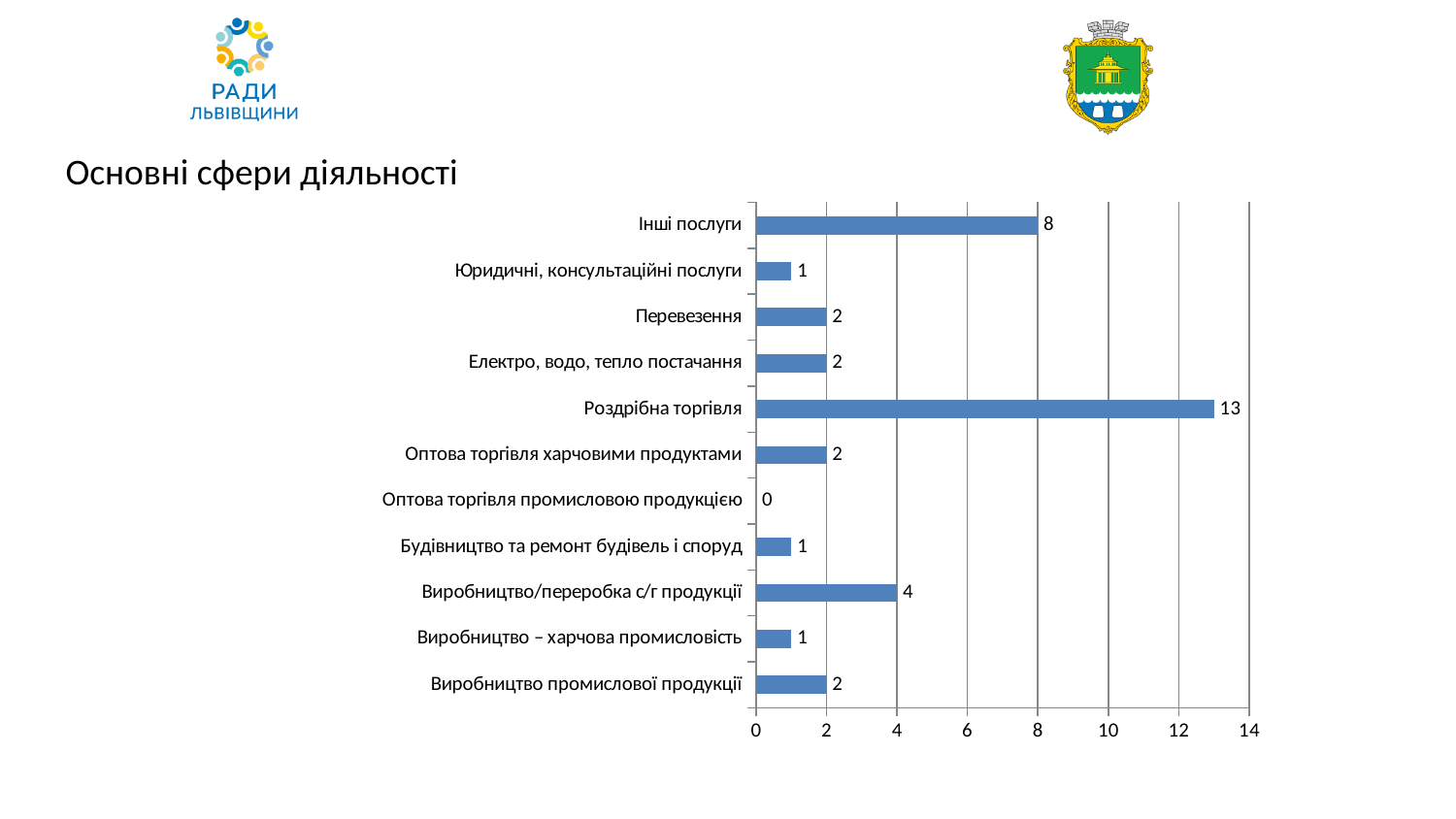
What is the value for Оптова торгівля промисловою продукцією? 0 Which category has the lowest value? Оптова торгівля промисловою продукцією What kind of chart is shown on the slide? bar chart What is the difference between the values for Роздрібна торгівля and Інші послуги? 5 What is the value for Інші послуги? 8 How many categories are shown in the chart? 11 What is the value for Роздрібна торгівля? 13 What is the title of the slide? Основні сфери діяльності Which category has the highest value? Роздрібна торгівля What is the value for Виробництво/переробка с/г продукції? 4 Which is larger, the value for Виробництво/переробка с/г продукції or the value for Перевезення? Виробництво/переробка с/г продукції Is the value for Роздрібна торгівля greater or less than 10? greater